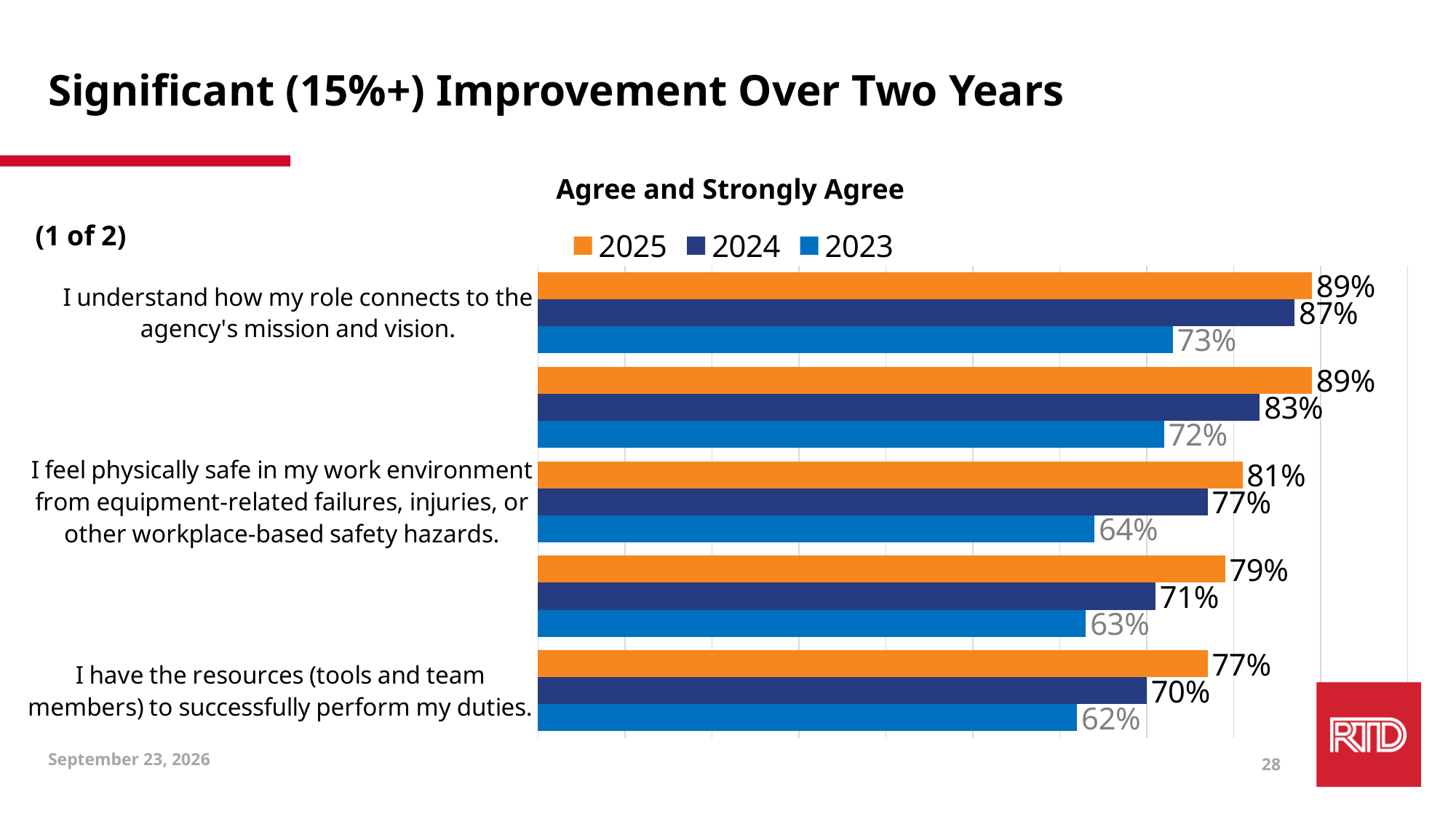
What is the 2024 value for "I have the resources (tools and team members) to successfully perform my duties."? 70% What kind of chart is shown on the slide? Bar chart What is the difference between the 2025 and 2023 values for "I understand how my role connects to the agency's mission and vision."? 16% Which is larger for "I feel physically safe in my work environment from equipment-related failures, injuries, or other workplace-based safety hazards.": the 2024 value or the 2023 value? 2024 How many groups of bars are plotted in the chart? 5 Which year has the lowest value for "I have the resources (tools and team members) to successfully perform my duties."? 2023 How many series does the legend list? 3 What is the 2023 value for "I feel physically safe in my work environment from equipment-related failures, injuries, or other workplace-based safety hazards."? 64% What is the 2025 value for "I understand how my role connects to the agency's mission and vision."? 89% What is the difference between the 2025 and 2023 values for "I have the resources (tools and team members) to successfully perform my duties."? 15% What is the title of the chart? Agree and Strongly Agree What is the 2023 value for "I understand how my role connects to the agency's mission and vision."? 73%